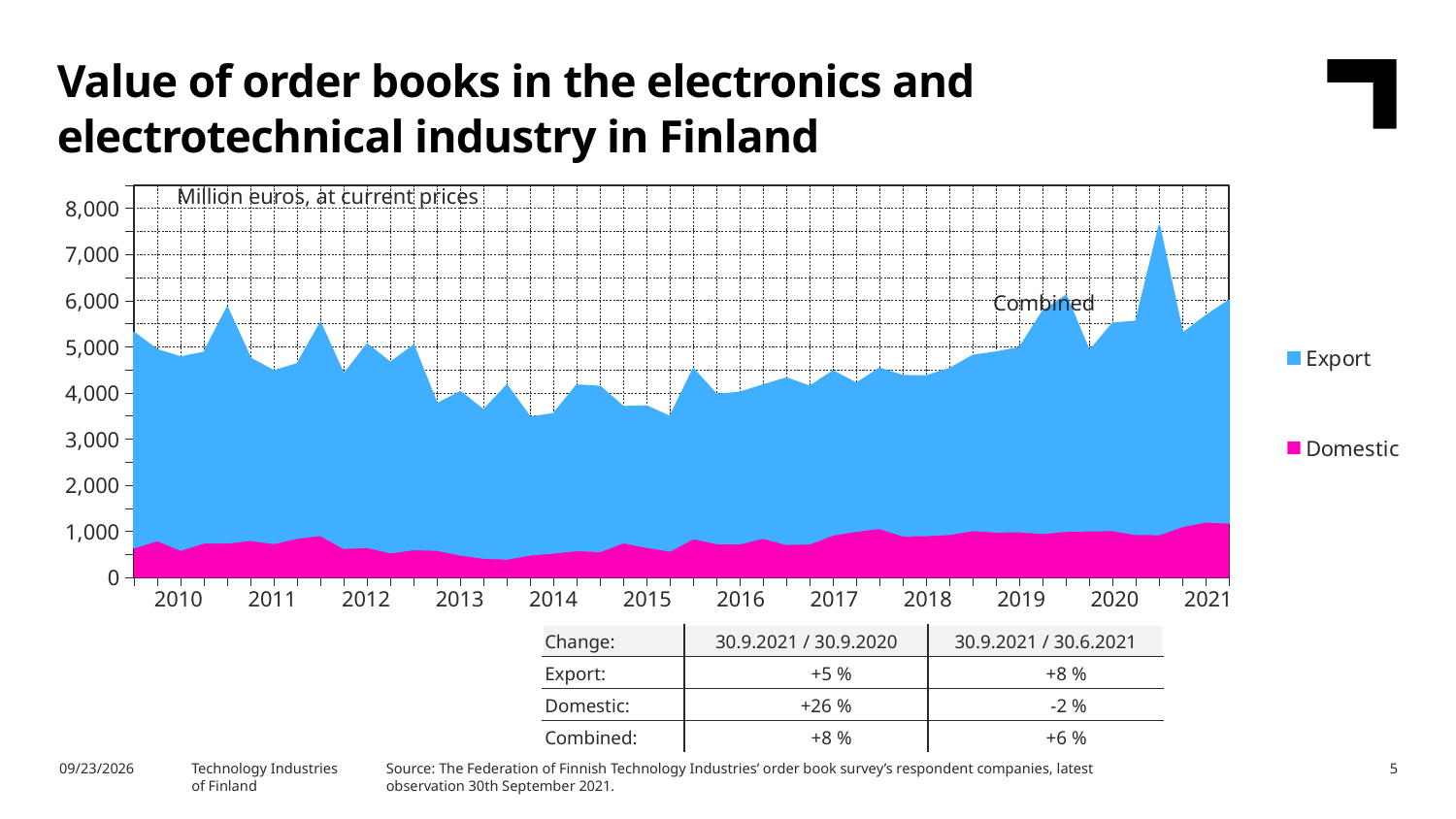
How many series does the chart's legend list? 2 Is the Domestic value of order books during 2014 greater or less than 1,000? less Is the combined value of order books at the start of 2010 greater or less than 4,000? greater Which is larger, the combined value of order books at the start of 2010 or during 2016? Start of 2010 Is the combined value of order books during 2016 greater or less than 5,000? less In what unit are the values on the chart expressed, according to the label above the plot? Million euros, at current prices In which year does the combined value of order books reach its highest peak? 2020 Does the Domestic value of order books generally rise or fall from 2014 to 2021? Rise What are the two series named in the chart's legend? Export and Domestic How many years are labelled on the x axis of the chart? 12 What kind of chart is shown on the slide? Area chart